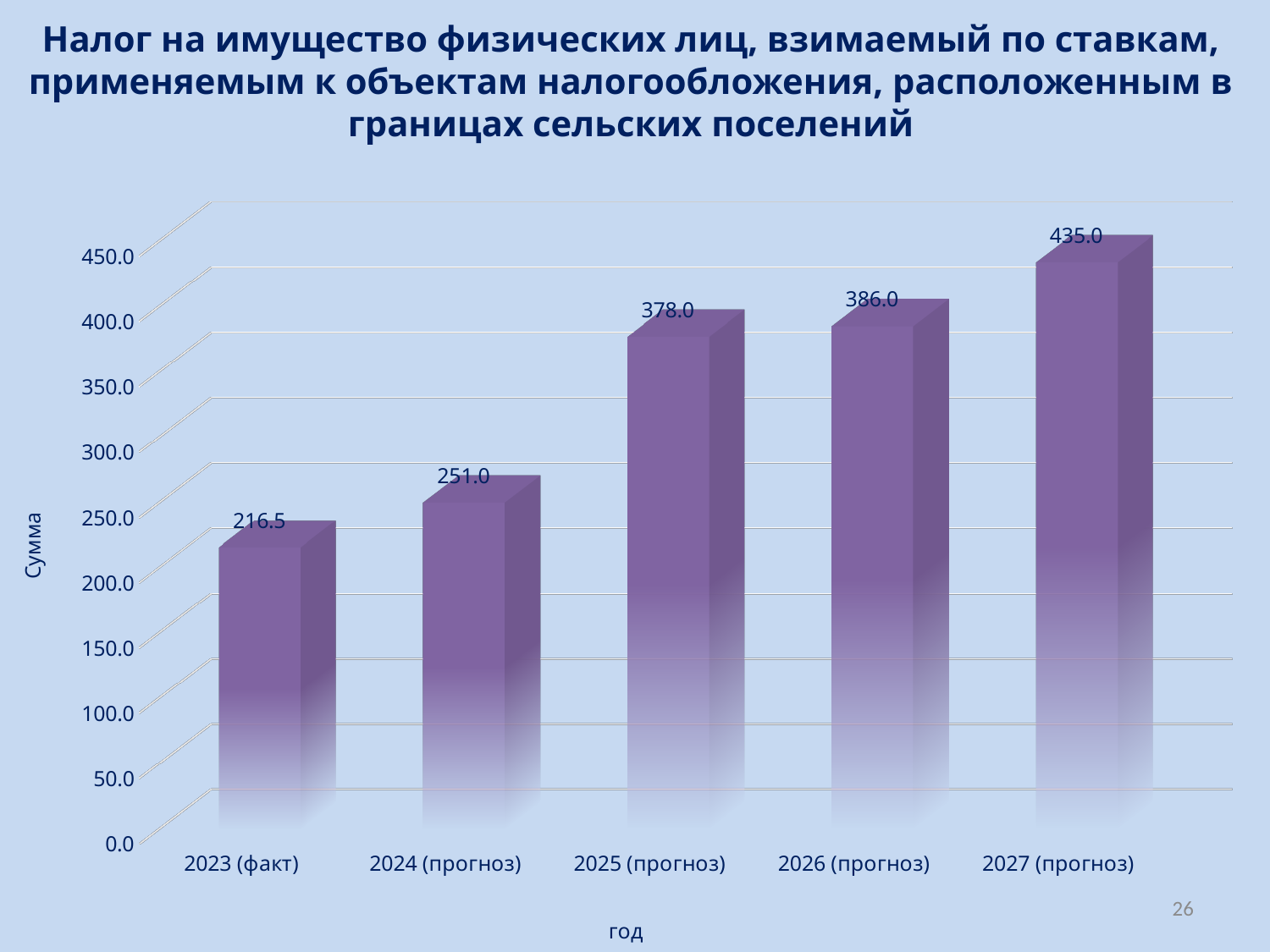
How many years are shown on the x axis? 5 What is the value for 2025 (прогноз)? 378.0 Which year has the lowest value? 2023 (факт) What is the value for 2023 (факт)? 216.5 What is the value for 2027 (прогноз)? 435.0 Do the values rise or fall from 2023 to 2027? rise What kind of chart is shown on the slide? bar chart What is the difference between the values for 2027 (прогноз) and 2023 (факт)? 218.5 Is the value for 2024 (прогноз) greater or less than 300.0? less Which is larger, the value for 2024 (прогноз) or the value for 2025 (прогноз)? 2025 (прогноз) Which year has the highest value? 2027 (прогноз) What is the difference between the values for 2026 (прогноз) and 2025 (прогноз)? 8.0